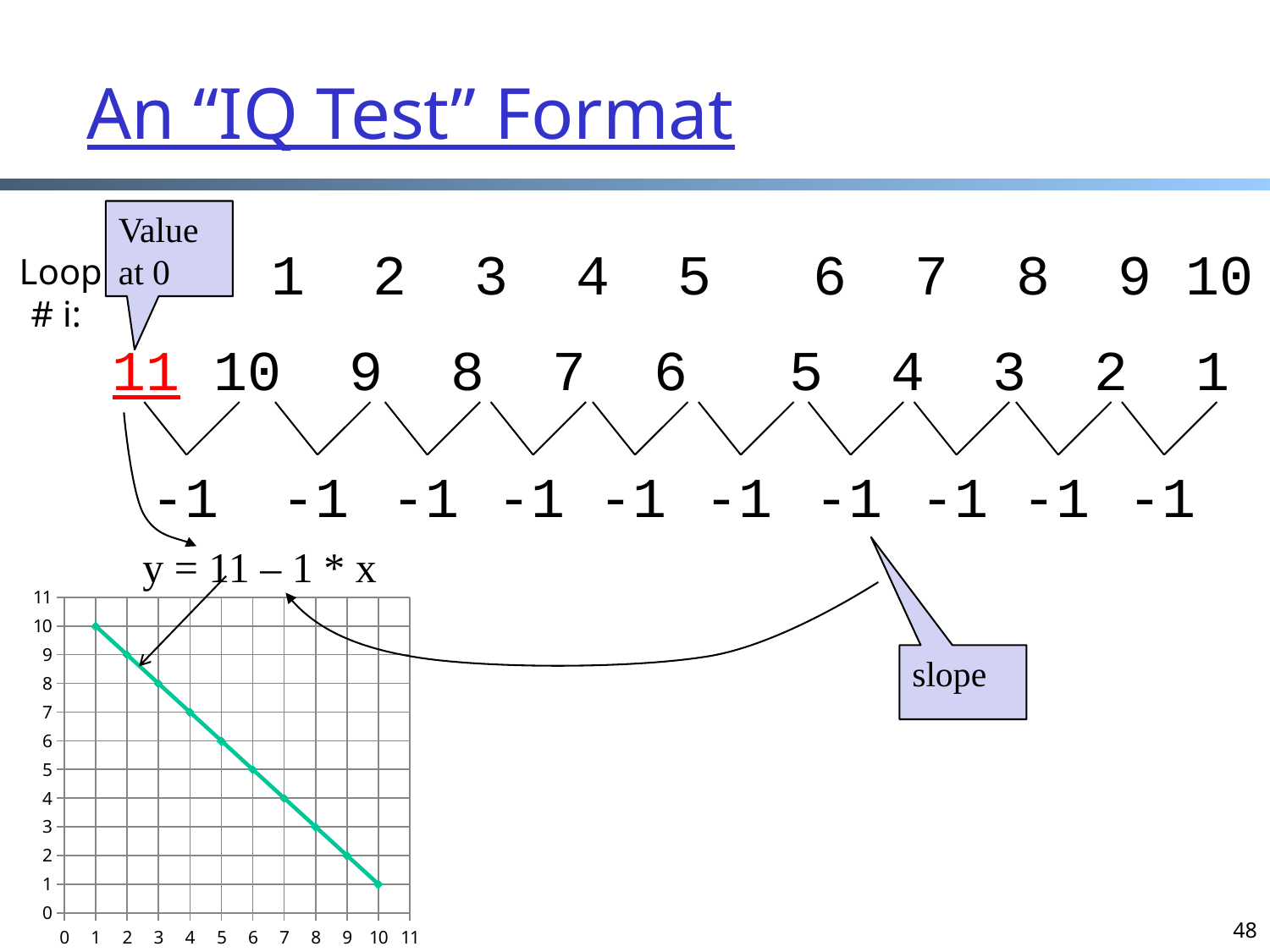
In the chart, what is the y value at x = 10? 1 In the chart, what is the y value at x = 1? 10 In the chart, what is the y value at x = 5? 6 What is the highest tick value shown on the chart's y axis? 11 What kind of chart is shown at the bottom left of the slide? line chart How many data points are plotted on the line in the chart? 10 Do the plotted values rise or fall as x increases along the chart's x axis? fall In the chart, at which x value is the plotted y value lowest? 10 In the chart, is the y value at x = 2 greater or less than 5? greater In the chart, at which x value is the plotted y value highest? 1 In the chart, what is the difference between the y value at x = 1 and the y value at x = 10? 9 In the chart, which is larger: the y value at x = 3 or the y value at x = 7? x = 3